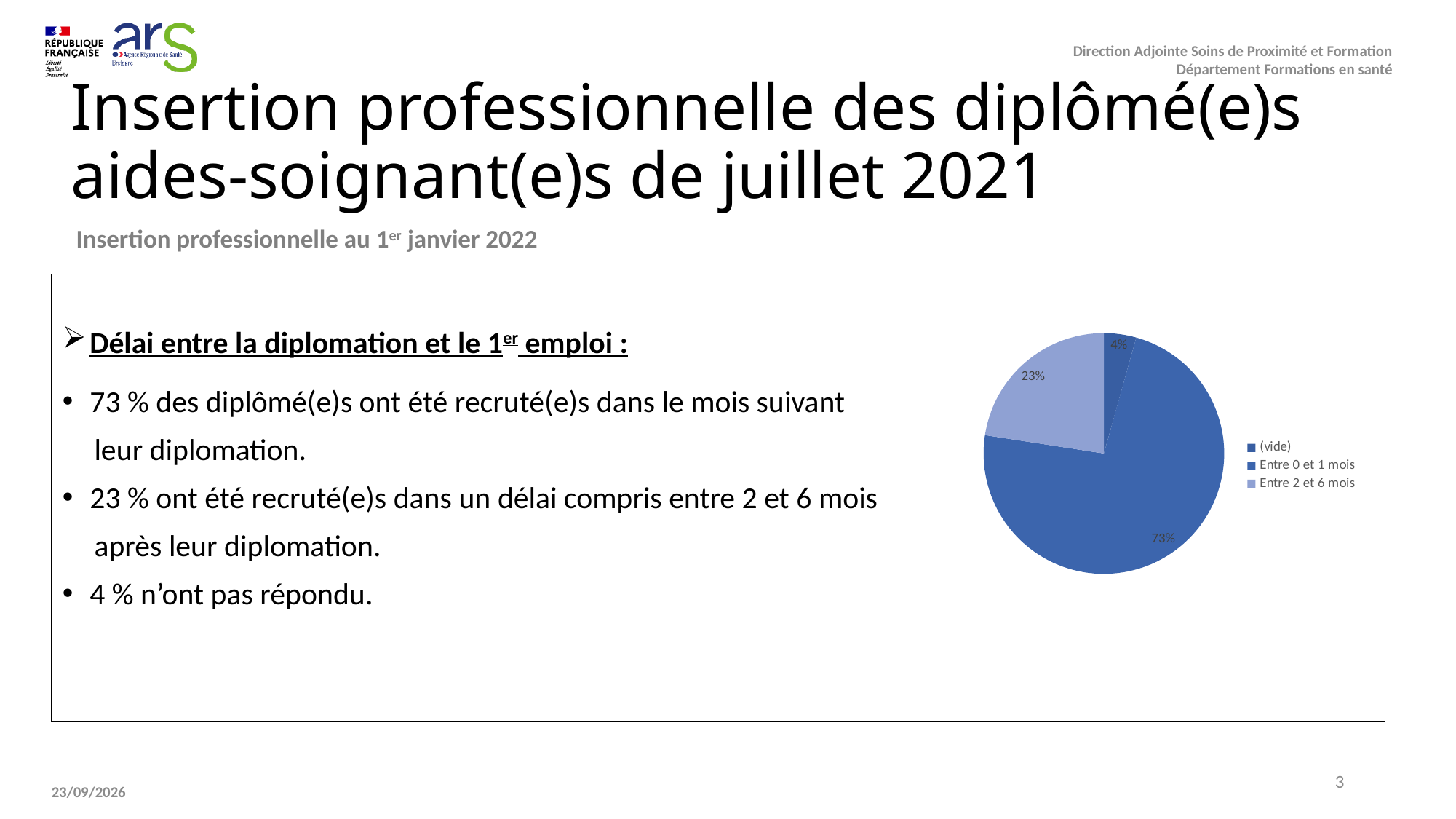
Which category has the smallest slice of the pie? (vide) What share of the pie does "Entre 2 et 6 mois" represent? 23% Which legend entry is shown in the lightest blue colour? Entre 2 et 6 mois What is the difference between the shares for "Entre 0 et 1 mois" and "Entre 2 et 6 mois"? 50% What share of the pie does "Entre 0 et 1 mois" represent? 73% What is the difference between the shares for "Entre 2 et 6 mois" and "(vide)"? 19% How many entries does the legend list? 3 What share of the pie does "(vide)" represent? 4% How many slices does the pie chart have? 3 Which is larger, the share for "Entre 2 et 6 mois" or the share for "(vide)"? Entre 2 et 6 mois What kind of chart is shown on the slide? pie chart Which category has the largest slice of the pie? Entre 0 et 1 mois